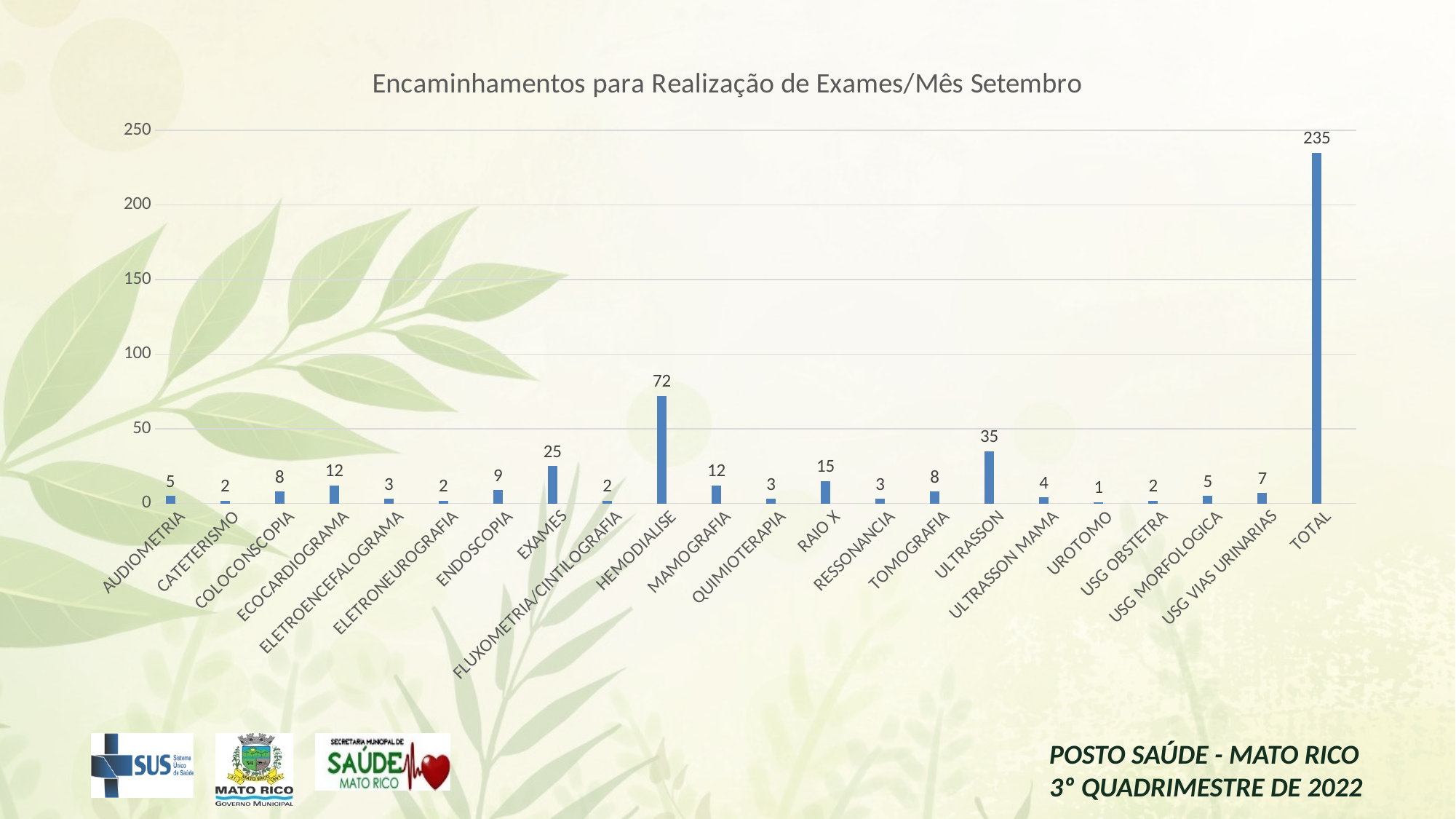
Which category has the lowest value? UROTOMO What kind of chart is shown on the slide? Bar chart What is the value for RAIO X? 15 How many bars are plotted in the chart, including TOTAL? 22 What is the difference between the values for HEMODIALISE and ULTRASSON? 37 What is the value for ULTRASSON? 35 Is the value for TOTAL greater or less than 200? greater What is the value shown for the TOTAL bar? 235 What is the value for HEMODIALISE? 72 What is the title of the chart? Encaminhamentos para Realização de Exames/Mês Setembro Excluding the TOTAL bar, which exam category has the highest value? HEMODIALISE Which is larger, the value for EXAMES or the value for RAIO X? EXAMES